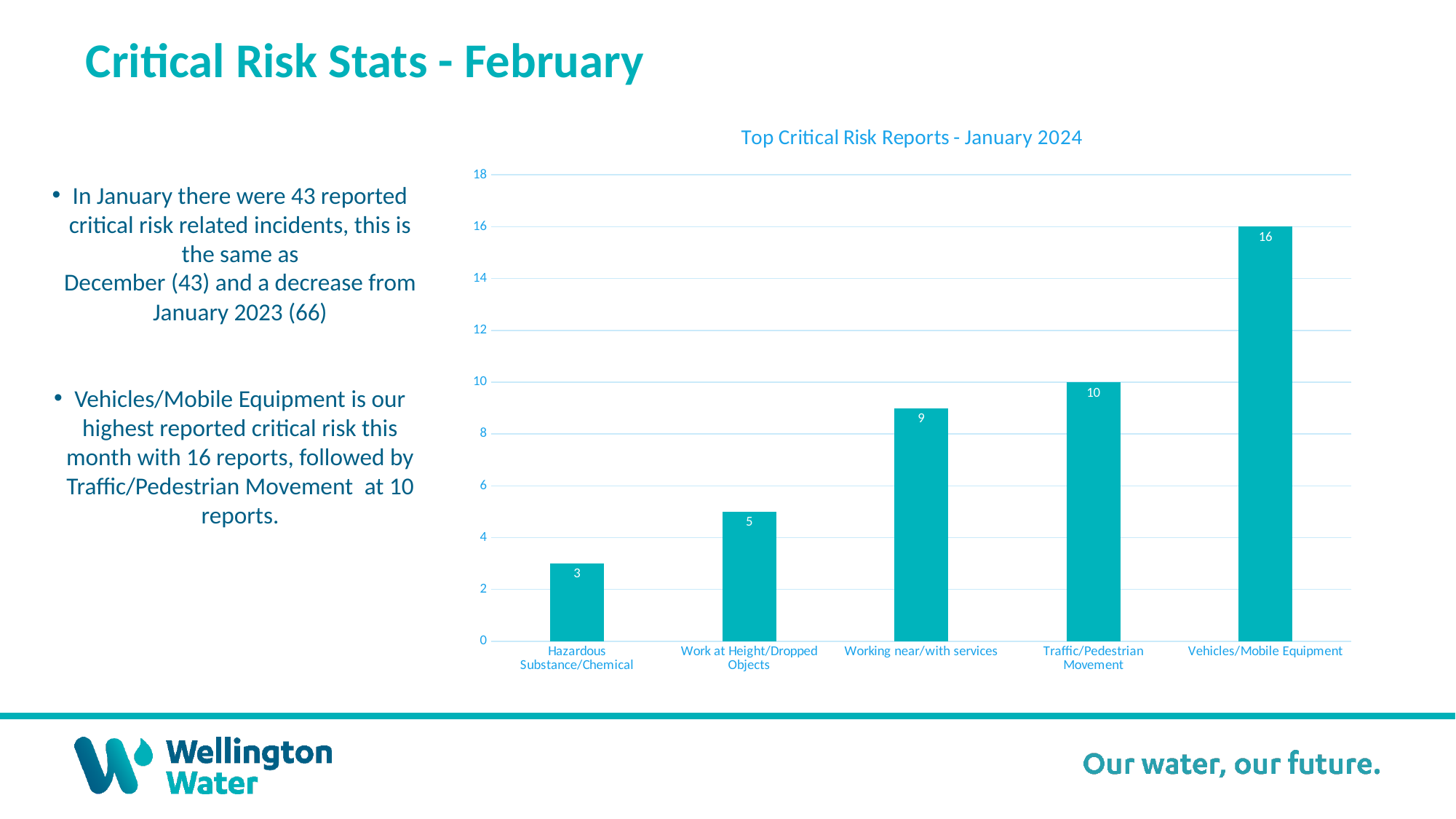
What is the title of the chart? Top Critical Risk Reports - January 2024 What is the value for Vehicles/Mobile Equipment? 16 What is the value for Work at Height/Dropped Objects? 5 Is the value for Traffic/Pedestrian Movement greater or less than 8? greater What kind of chart is shown on the slide? bar chart What is the value for Hazardous Substance/Chemical? 3 What is the value for Working near/with services? 9 Which category has the lowest value? Hazardous Substance/Chemical Which category has the highest value? Vehicles/Mobile Equipment Which is larger, the value for Working near/with services or the value for Work at Height/Dropped Objects? Working near/with services What is the difference between the values for Vehicles/Mobile Equipment and Traffic/Pedestrian Movement? 6 How many categories are shown on the chart? 5